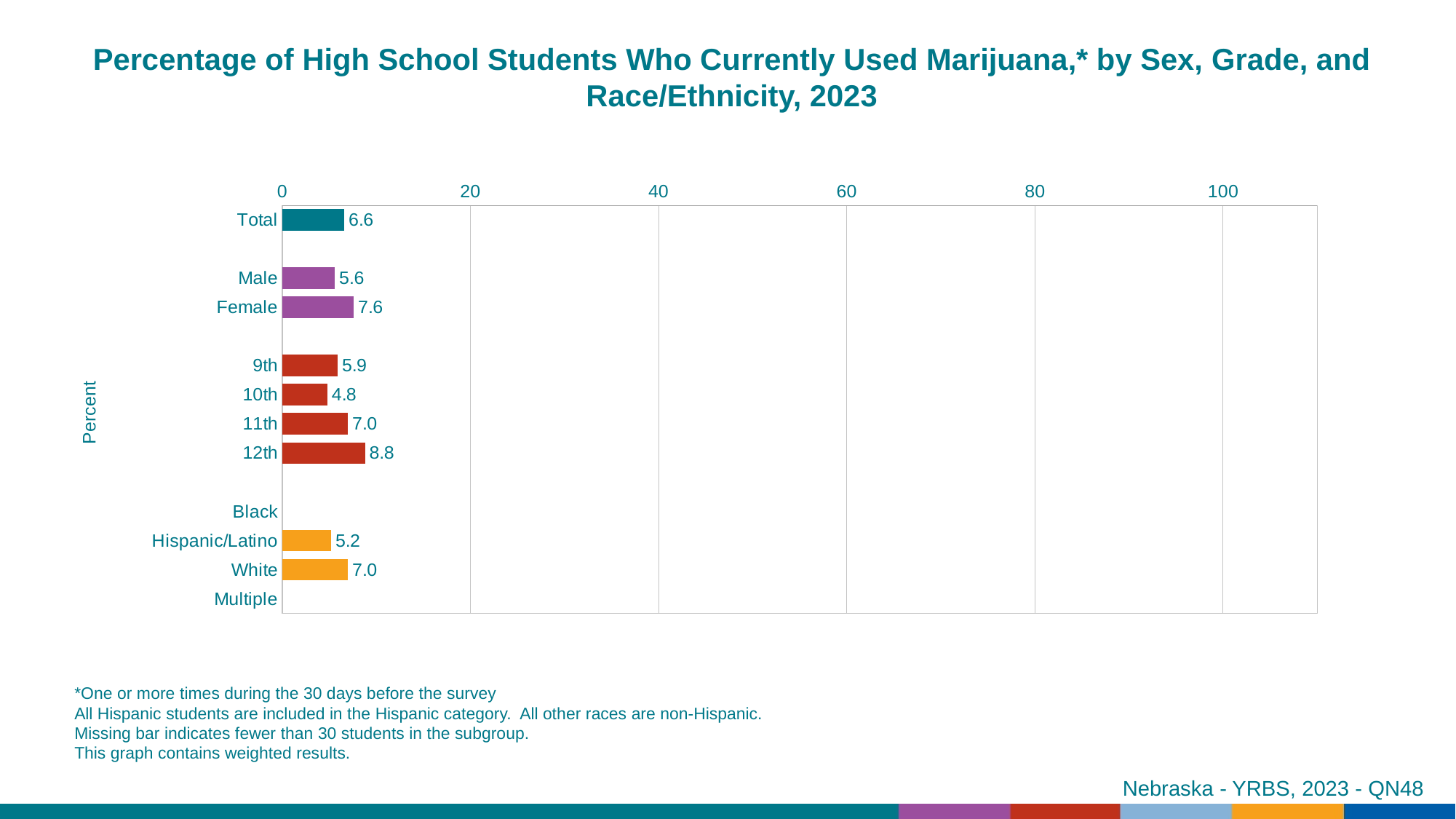
What is the value for Hispanic/Latino? 5.2 What is the value for 10th grade? 4.8 What is the value for Total? 6.6 Is the value for 12th grade greater or less than 20? less Which grade has the highest value? 12th What is the difference between the Female and Male values? 2.0 Which is larger, the value for 11th grade or the value for 9th grade? 11th Which grade has the lowest value? 10th Which race/ethnicity categories have no bar shown? Black and Multiple What is the value for Female? 7.6 What kind of chart is shown on the slide? Bar chart What is the difference between the 12th grade and 10th grade values? 4.0